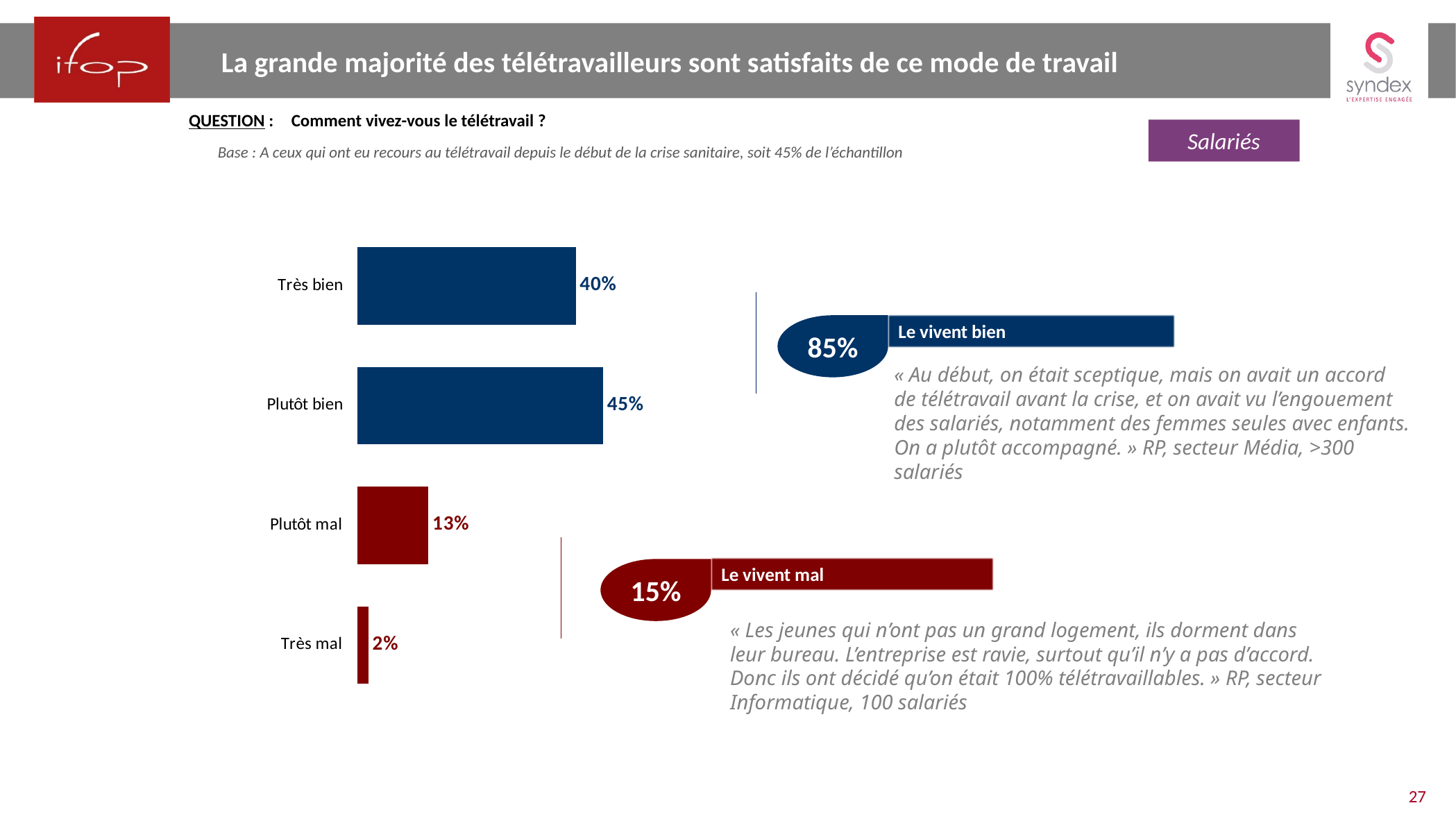
How many categories are shown in the chart? 4 Which is larger, the value for "Très bien" or the value for "Plutôt mal"? Très bien What percentage is shown in the "Le vivent bien" summary bubble? 85% What is the value for "Plutôt bien"? 45% What is the value for "Plutôt mal"? 13% What is the value for "Très mal"? 2% What is the value for "Très bien"? 40% What kind of chart is shown on the slide? Bar chart What is the difference between the values for "Plutôt bien" and "Très bien"? 5% Which category has the highest value? Plutôt bien What is the difference between the values for "Plutôt mal" and "Très mal"? 11% Which category has the lowest value? Très mal